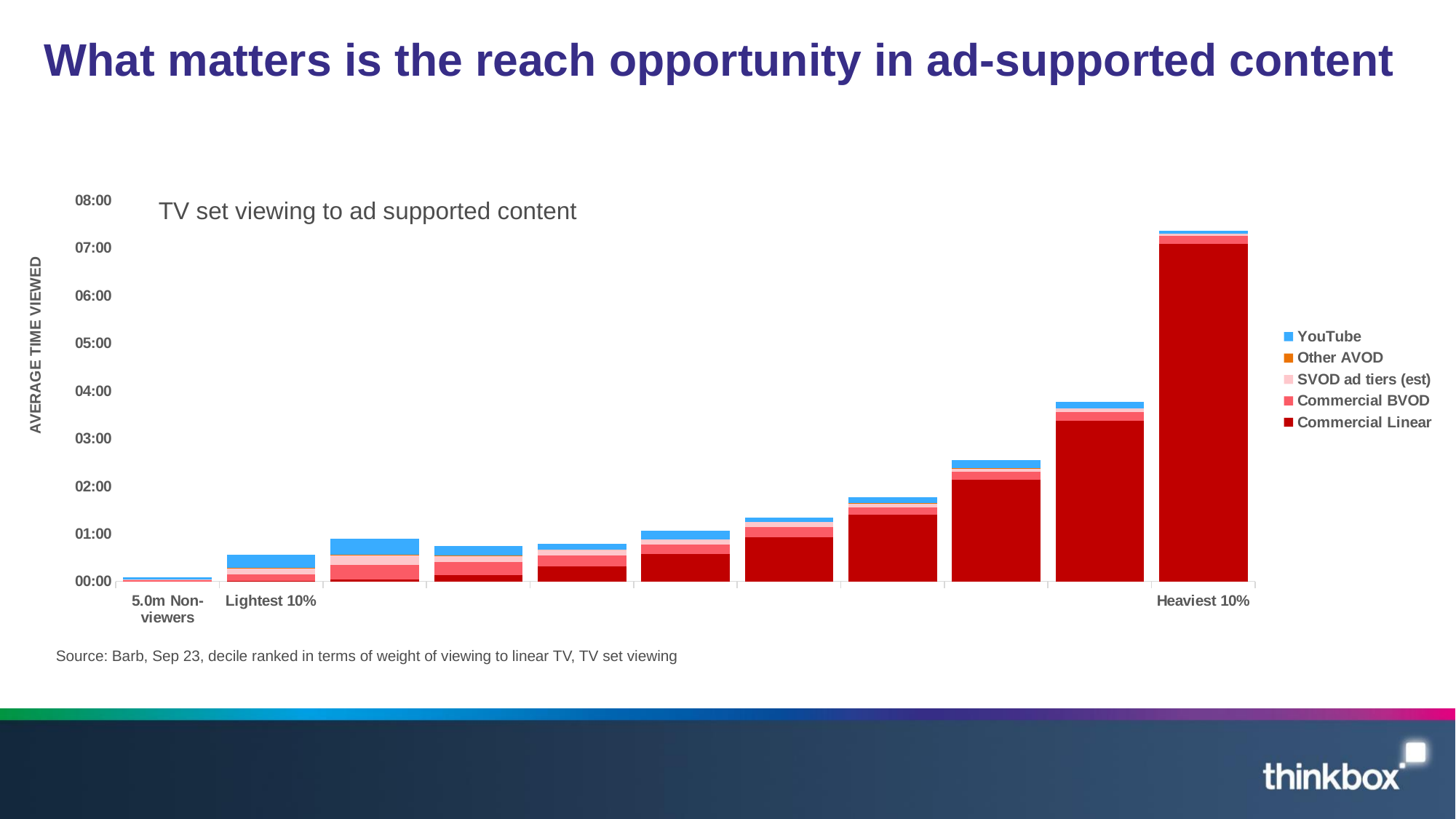
What kind of chart is shown on the slide? Stacked bar chart What is the label on the vertical axis? AVERAGE TIME VIEWED Which category has the lowest total average time viewed? 5.0m Non-viewers What is the title of the chart? TV set viewing to ad supported content Is the total value for 5.0m Non-viewers greater or less than 01:00? less Is the total value for Heaviest 10% greater or less than 07:00? greater How many series does the legend list? 5 Is the total value for Lightest 10% greater or less than 01:00? less Do the bar totals generally rise or fall moving from left to right along the x axis? Rise Which has a larger total average time viewed, Lightest 10% or Heaviest 10%? Heaviest 10% Which category has the highest total average time viewed? Heaviest 10% How many bars are plotted in the chart? 11